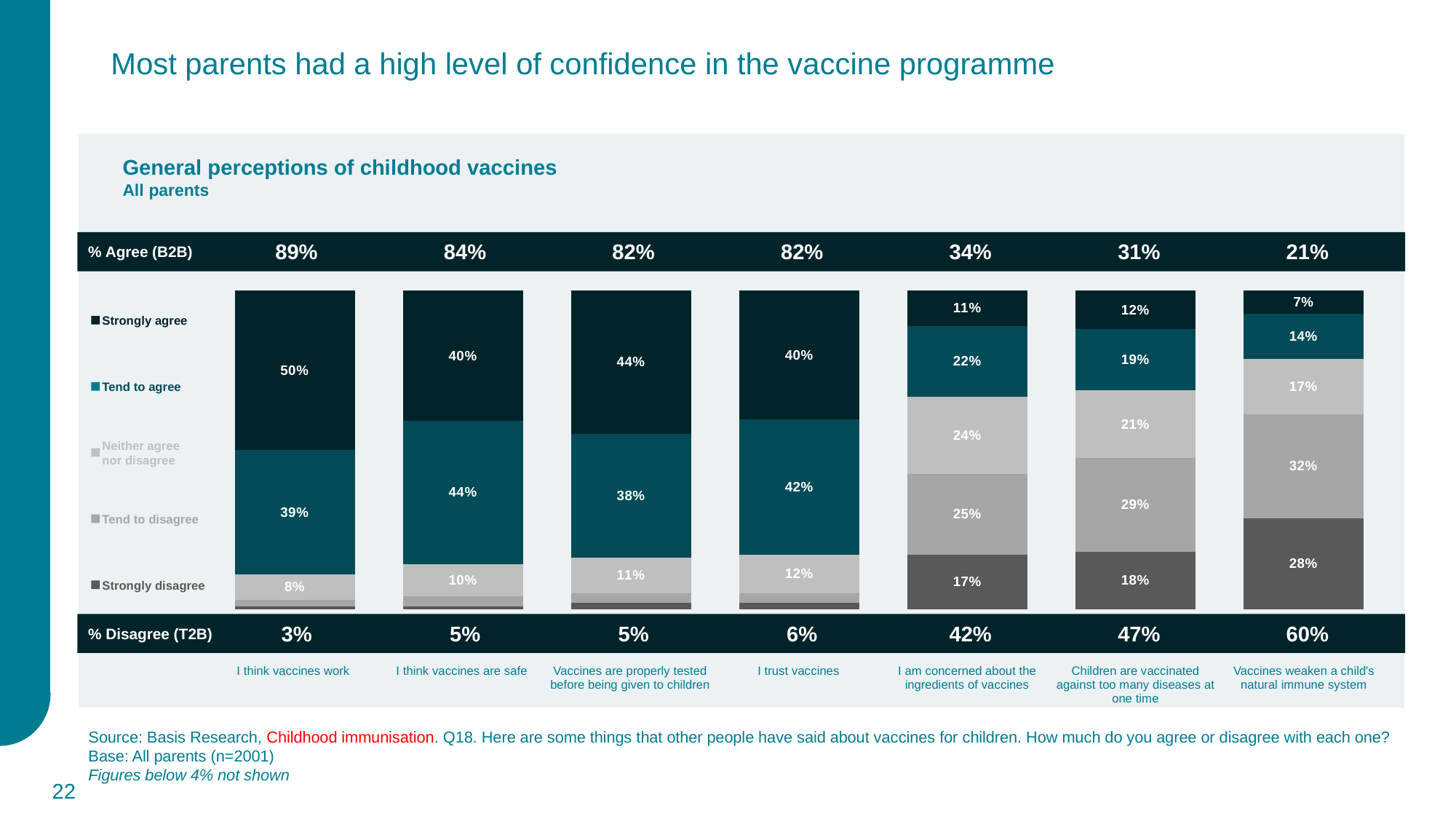
What is the 'Neither agree nor disagree' value for 'I am concerned about the ingredients of vaccines'? 24% What is the 'Strongly agree' value for 'I think vaccines work'? 50% Which statement has the highest 'Strongly agree' value? I think vaccines work What is the difference in 'Strongly agree' between 'I think vaccines work' and 'I think vaccines are safe'? 10 percentage points How many series does the legend list? 5 What is the 'Tend to agree' value for 'I trust vaccines'? 42% What type of chart is shown on the slide? Stacked bar chart Which statement has the lowest 'Strongly agree' value? Vaccines weaken a child's natural immune system What is the 'Strongly disagree' value for 'Vaccines weaken a child's natural immune system'? 28% How many statements (categories) are plotted in the chart? 7 Which has the larger 'Tend to agree' value: 'I think vaccines are safe' or 'I think vaccines work'? I think vaccines are safe What is the title of the chart? General perceptions of childhood vaccines